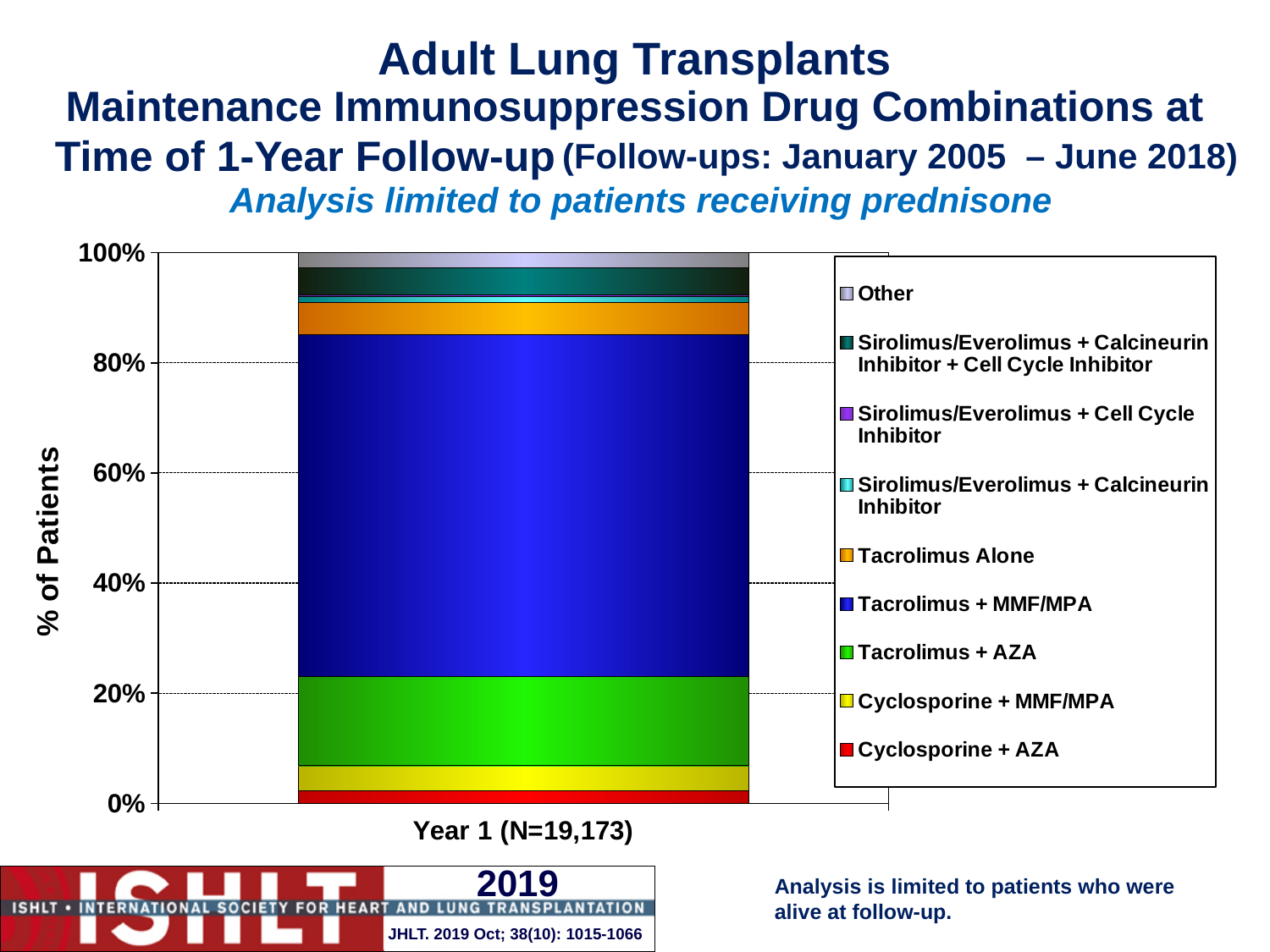
What is the label on the y axis? % of Patients Does the top of the Tacrolimus + MMF/MPA segment lie above or below the 80% gridline? above What kind of chart is shown on the slide? Stacked bar chart Which segment is larger: Tacrolimus + MMF/MPA or Tacrolimus Alone? Tacrolimus + MMF/MPA Which drug combination makes up the largest segment of the Year 1 bar? Tacrolimus + MMF/MPA Is the share of patients on Tacrolimus + MMF/MPA greater or less than 40%? greater What is the label on the x axis beneath the bar? Year 1 (N=19,173) Which segment is larger: Tacrolimus + AZA or Cyclosporine + MMF/MPA? Tacrolimus + AZA How many drug combination series does the legend list? 9 How many bars (categories) are plotted on the x axis? 1 Is the share of patients on Cyclosporine + AZA greater or less than 20%? less